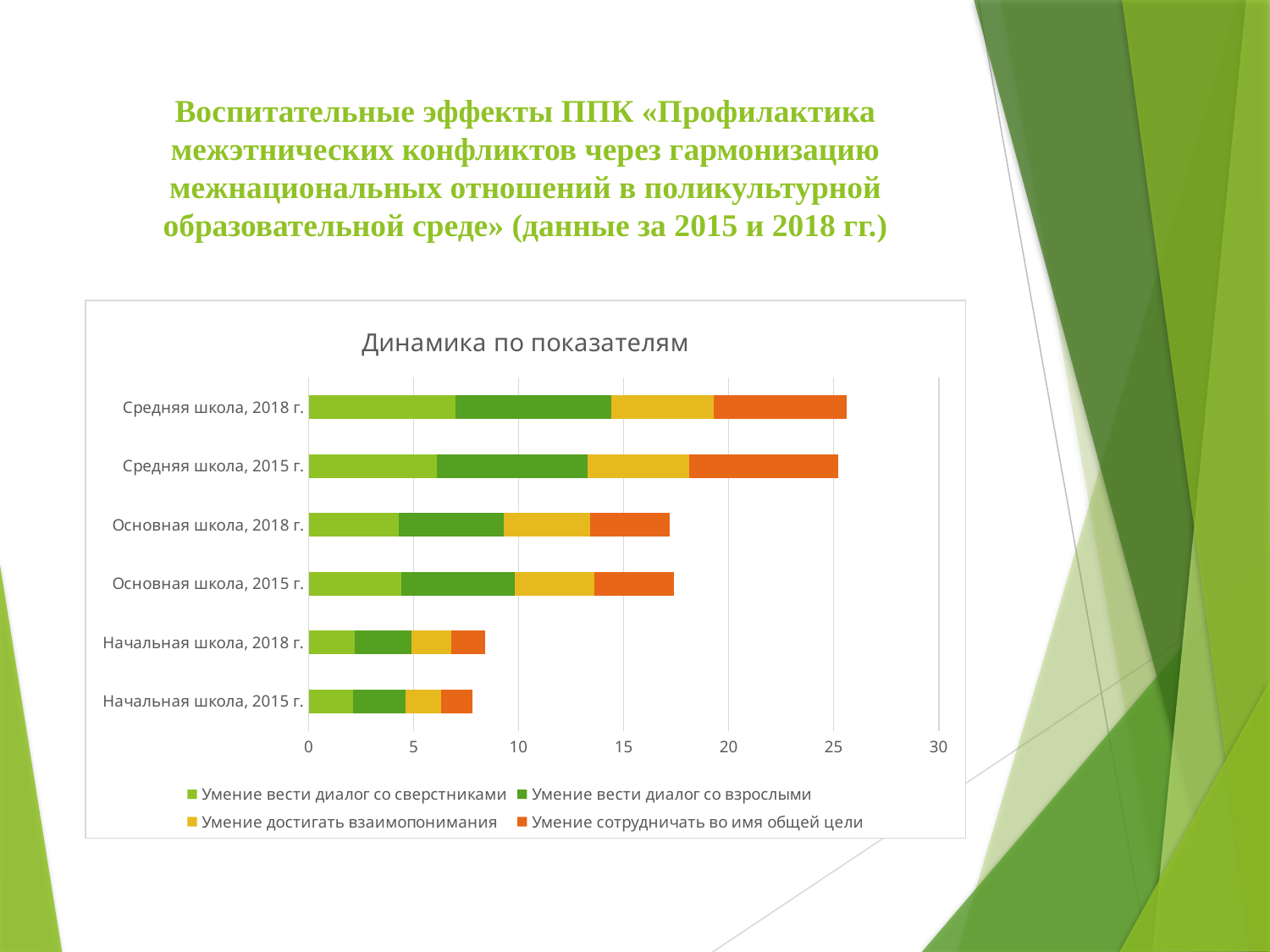
Which has the longer total bar: Основная школа, 2015 г. or Начальная школа, 2015 г.? Основная школа, 2015 г. Which has the longer total bar: Средняя школа, 2018 г. or Основная школа, 2018 г.? Средняя школа, 2018 г. How many categories are shown on the chart's vertical axis? 6 How many series does the chart's legend list? 4 Which series is shown in orange in the legend? Умение сотрудничать во имя общей цели Is the total bar length for Средняя школа, 2018 г. greater or less than 25? greater Is the total bar length for Начальная школа, 2018 г. greater or less than 5? greater What kind of chart is shown on the slide? Stacked bar chart Is the total bar length for Основная школа, 2015 г. greater or less than 15? greater What is the title of the chart? Динамика по показателям